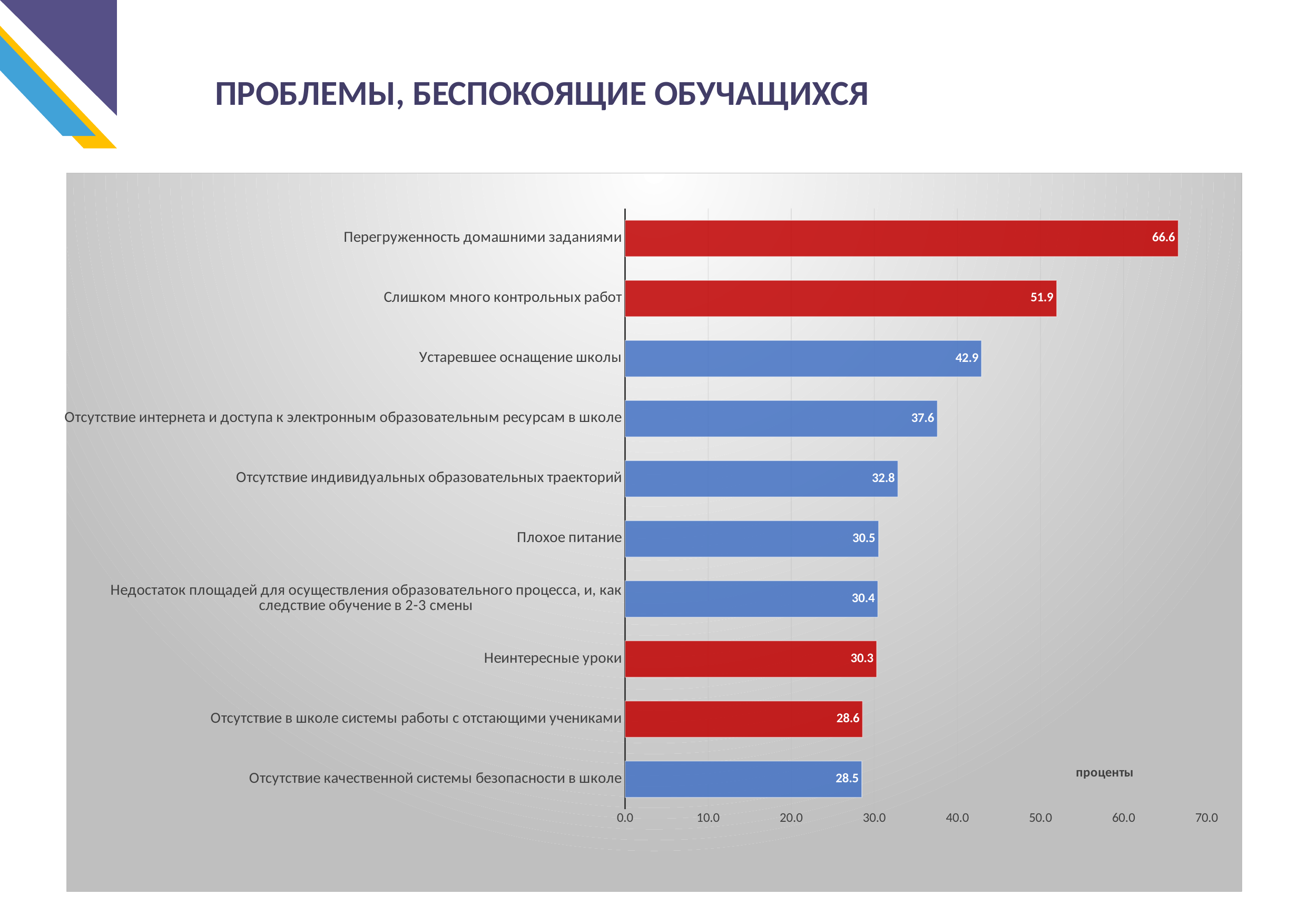
Which category has the highest value? Перегруженность домашними заданиями What is the value for "Перегруженность домашними заданиями"? 66.6 What is the difference between the values for "Перегруженность домашними заданиями" and "Слишком много контрольных работ"? 14.7 Which is larger: the value for "Отсутствие интернета и доступа к электронным образовательным ресурсам в школе" or for "Отсутствие индивидуальных образовательных траекторий"? Отсутствие интернета и доступа к электронным образовательным ресурсам в школе What is the label shown for the horizontal axis? проценты Which category has the lowest value? Отсутствие качественной системы безопасности в школе What is the title of the slide? ПРОБЛЕМЫ, БЕСПОКОЯЩИЕ ОБУЧАЩИХСЯ Is the value for "Слишком много контрольных работ" greater or less than 50.0? greater What is the value for "Устаревшее оснащение школы"? 42.9 What is the value for "Плохое питание"? 30.5 How many categories are shown in the chart? 10 What kind of chart is shown on the slide? bar chart